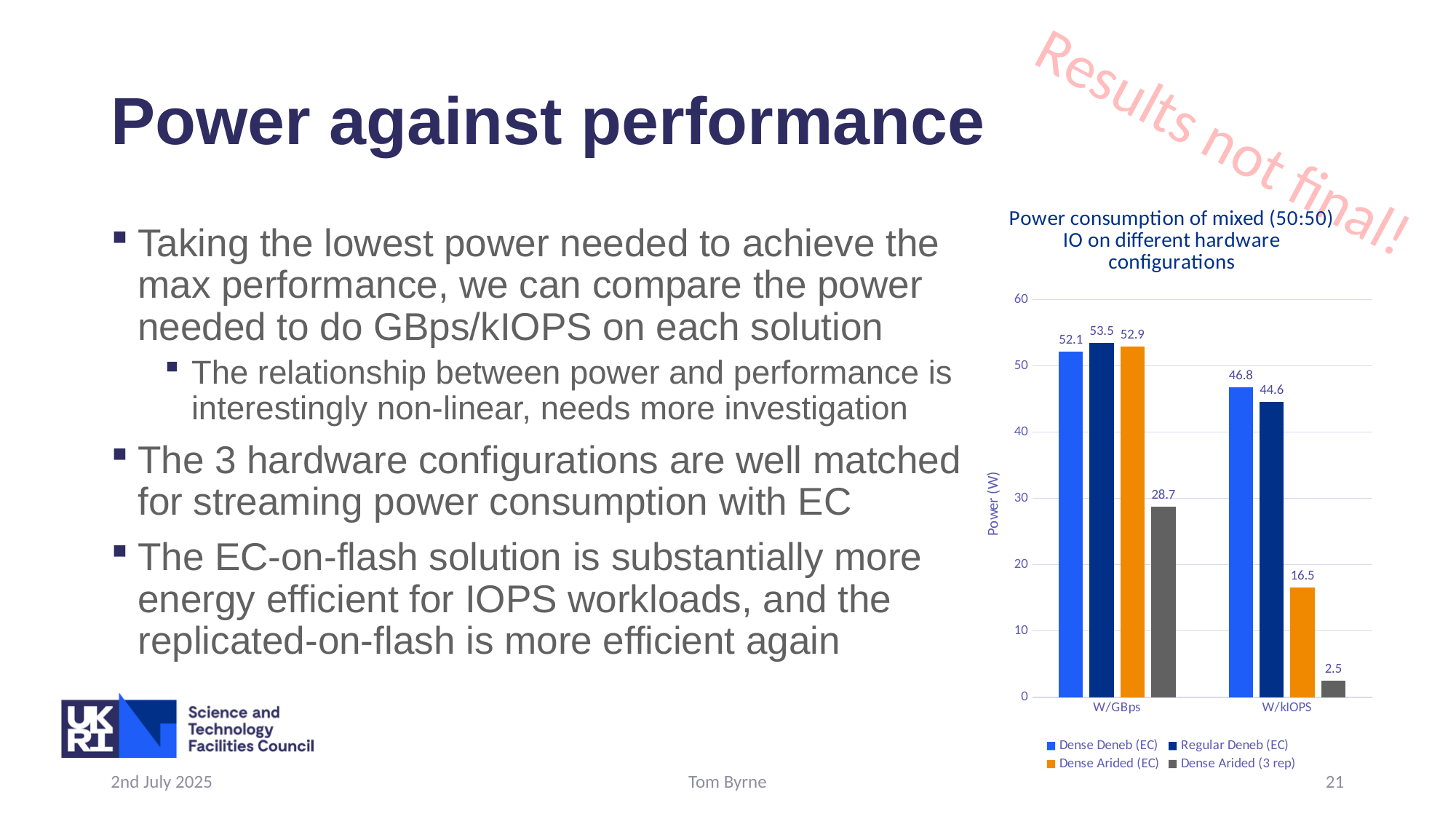
What kind of chart is shown on the slide? Bar chart What is the value for Dense Deneb (EC) in the W/GBps category? 52.1 What is the difference between the Dense Arided (EC) values for W/GBps and W/kIOPS? 36.4 What is the label of the y axis? Power (W) Which series has the highest value in the W/GBps category? Regular Deneb (EC) Is the value for Dense Arided (3 rep) in the W/GBps category greater or less than 30? less How many series does the legend list? 4 What is the value for Dense Arided (3 rep) in the W/kIOPS category? 2.5 What is the value for Regular Deneb (EC) in the W/kIOPS category? 44.6 How many categories are shown on the x axis? 2 Which series has the lowest value in the W/kIOPS category? Dense Arided (3 rep) Which is larger in the W/kIOPS category: Dense Deneb (EC) or Dense Arided (EC)? Dense Deneb (EC)